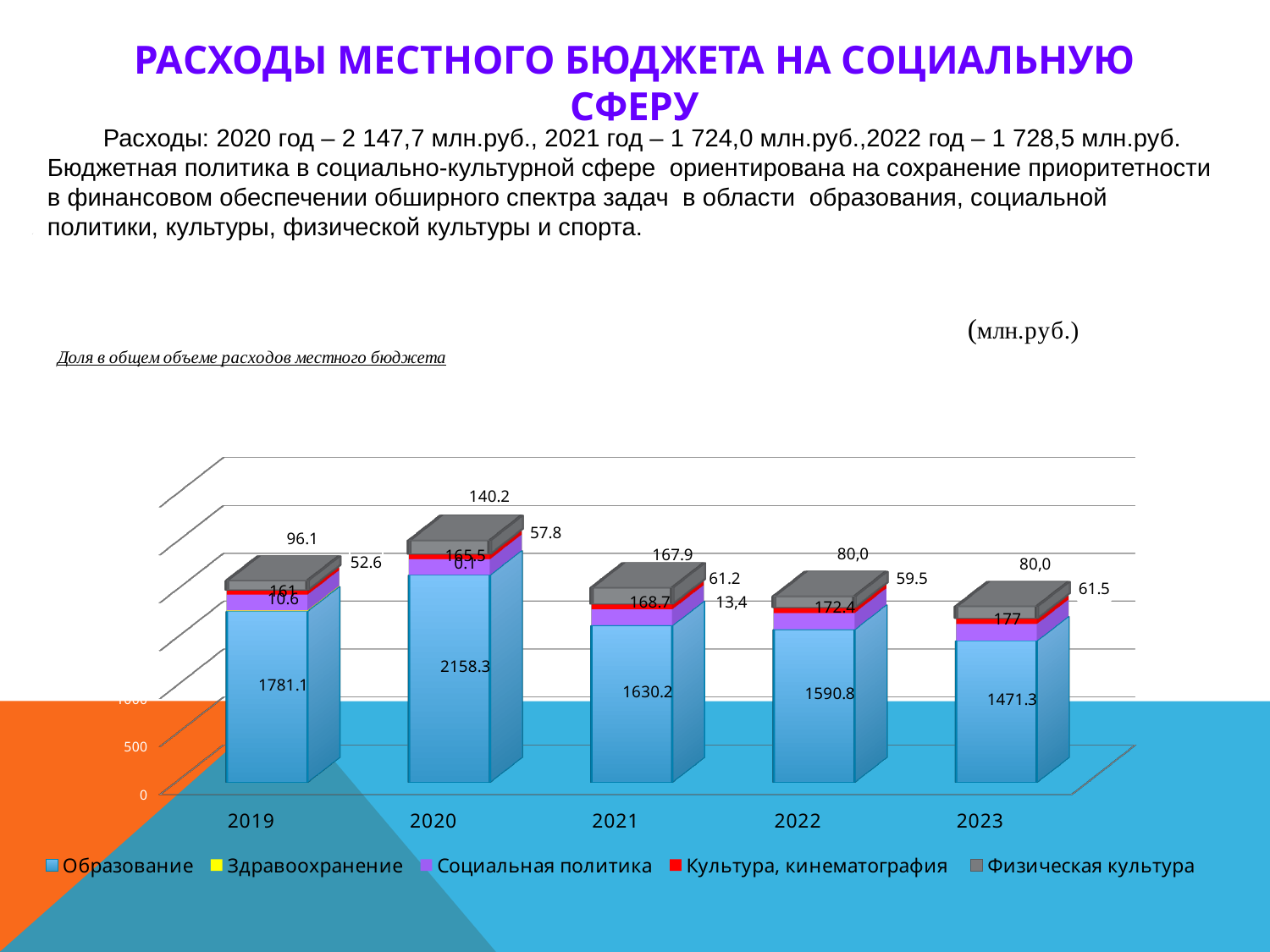
How many series does the chart legend list? 5 In which year is the value for Образование the highest? 2020 Does the value for Образование rise or fall from 2020 to 2023? Fall What kind of chart is shown on the slide? Stacked bar chart What is the value for Образование in 2020? 2158.3 Which is larger, the value for Культура, кинематография in 2021 or in 2022? 2021 What is the difference between the Образование values for 2019 and 2021? 150.9 What is the value for Социальная политика in 2023? 177 How many years are shown on the x axis of the chart? 5 What is the value for Физическая культура in 2021? 167.9 In which year is the value for Образование the lowest? 2023 What is the value for Образование in 2023? 1471.3